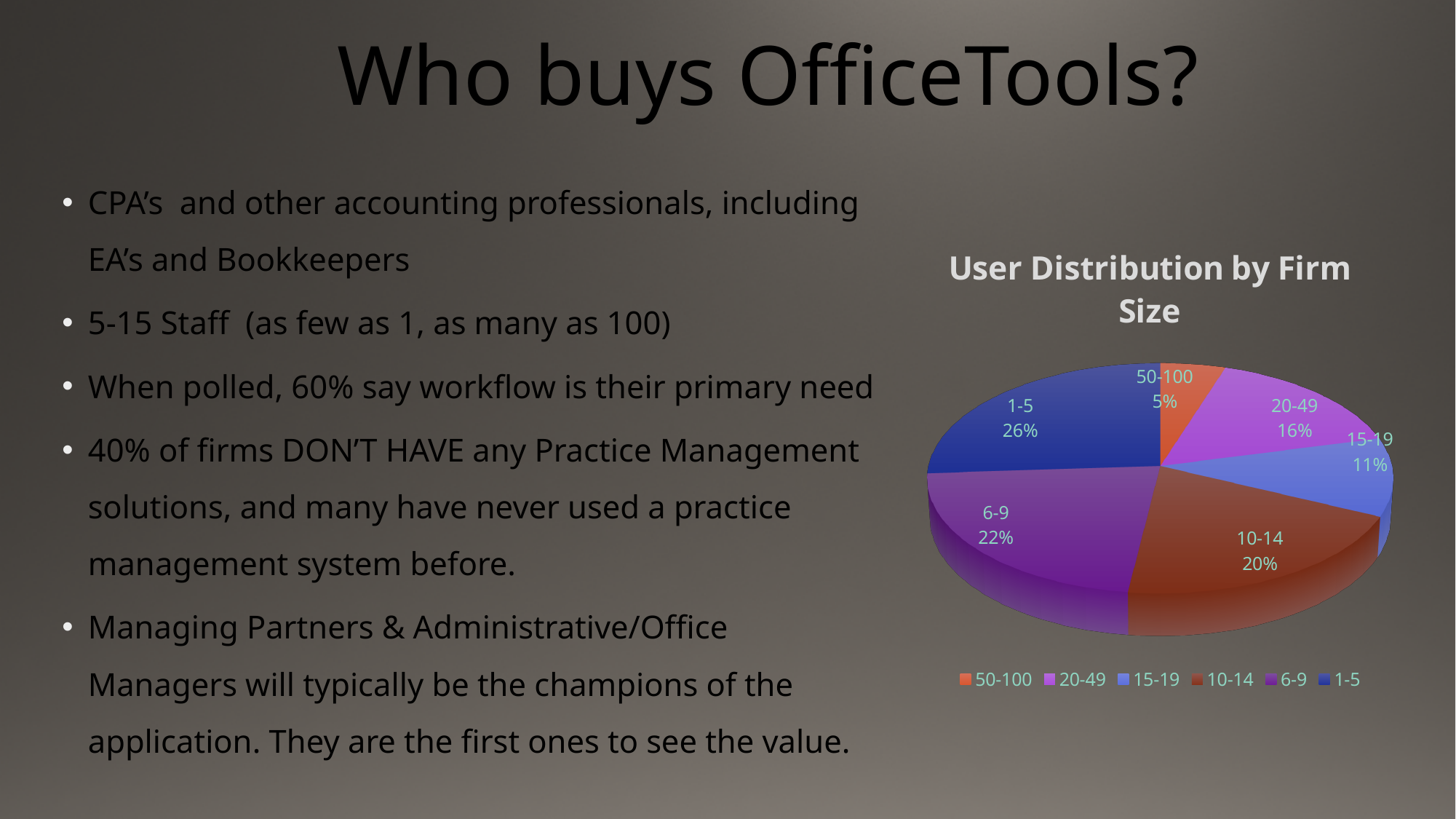
What share of users is in the 6-9 firm size category? 22% What share of users is in the 1-5 firm size category? 26% Which has a larger share, the 6-9 category or the 10-14 category? 6-9 What share of users is in the 10-14 firm size category? 20% Which firm size category has the smallest share of users? 50-100 What type of chart is shown on the slide? Pie chart What is the difference in share between the 20-49 and 15-19 categories? 5% What is the title of the chart? User Distribution by Firm Size Which firm size category has the largest share of users? 1-5 How many firm size categories are shown in the pie chart? 6 What is the combined share of the 1-5 and 6-9 categories? 48% What share of users is in the 50-100 firm size category? 5%